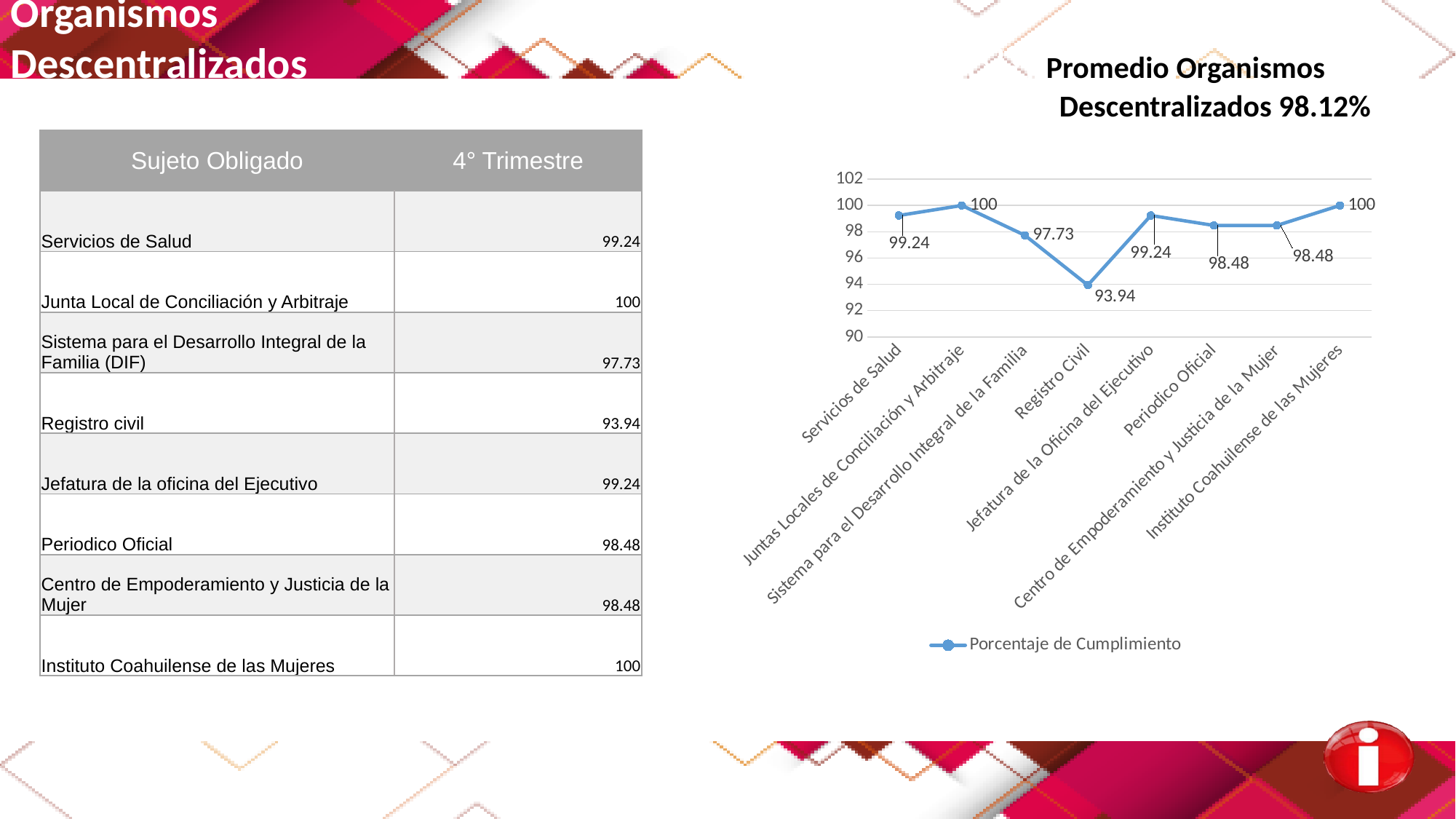
What is the difference between the value for Instituto Coahuilense de las Mujeres and the value for Registro Civil? 6.06 What is the value for Periodico Oficial in the chart? 98.48 Which is larger, the value for Jefatura de la Oficina del Ejecutivo or the value for Periodico Oficial? Jefatura de la Oficina del Ejecutivo What is the value for Sistema para el Desarrollo Integral de la Familia in the chart? 97.73 What is the value for Servicios de Salud in the chart? 99.24 What is the name of the series shown in the chart legend? Porcentaje de Cumplimiento What is the value for Registro Civil in the chart? 93.94 Which category has the lowest value in the chart? Registro Civil How many categories are plotted along the x axis of the chart? 8 Is the value for Registro Civil greater or less than 96? less How many series does the chart legend list? 1 What type of chart is shown on the slide? line chart